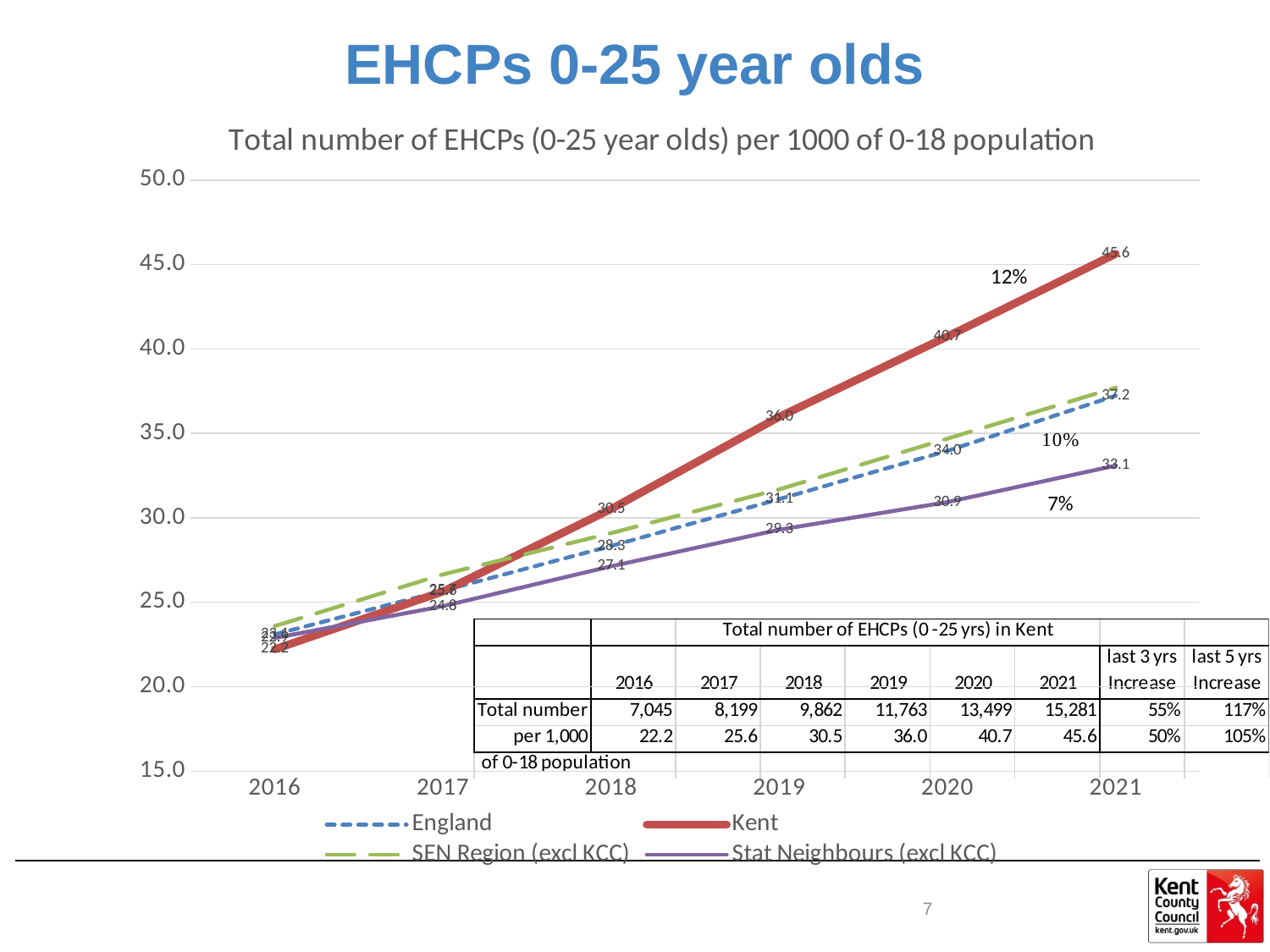
What is the value for Kent in 2019? 36.0 Which series has the lowest value in 2021? Stat Neighbours (excl KCC) How many years are plotted on the x axis? 6 Does the Kent line rise or fall from 2016 to 2021? rise What is the title of the chart? Total number of EHCPs (0-25 year olds) per 1000 of 0-18 population What is the value for Kent in 2021? 45.6 What kind of chart is shown on the slide? line chart Which series has the highest value in 2021? Kent How many series does the legend list? 4 Is the value for England in 2018 greater or less than 30.0? less By how much did the Kent value increase from 2016 to 2021? 23.4 What is the value for Kent in 2016? 22.2